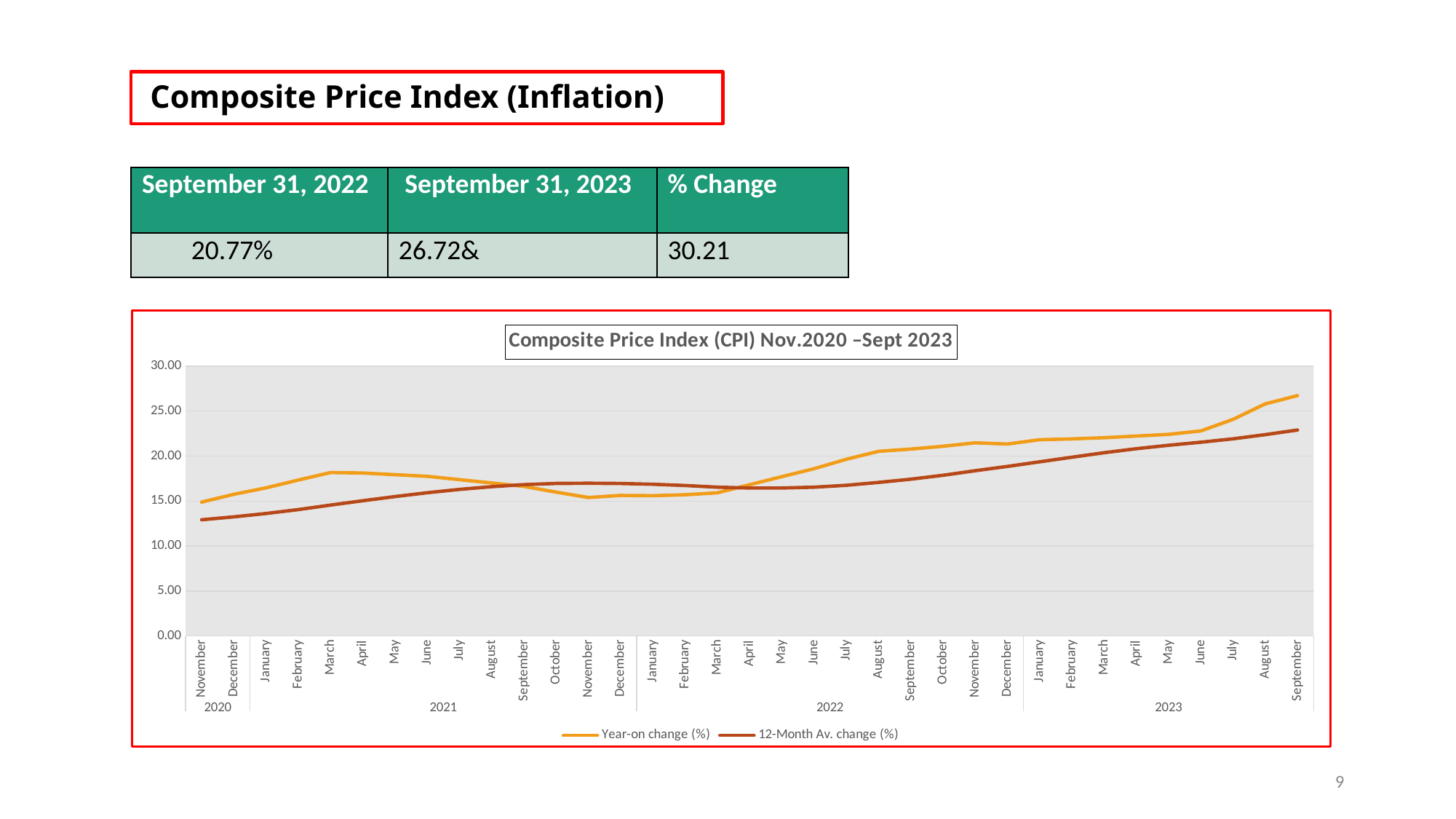
How many series does the chart legend list? 2 What kind of chart is shown on the slide? Line chart At which month does the Year-on change (%) series reach its highest value? September 2023 Is the Year-on change (%) value for September 2023 greater or less than 25? greater Is the Year-on change (%) value for March 2021 greater or less than 15? greater How many monthly data points are plotted along the x axis of the chart? 35 What are the two series named in the chart legend? Year-on change (%) and 12-Month Av. change (%) In November 2021, which series has the higher value, Year-on change (%) or 12-Month Av. change (%)? 12-Month Av. change (%) Is the 12-Month Av. change (%) value for November 2020 greater or less than 15? less What is the title of the chart? Composite Price Index (CPI) Nov.2020 –Sept 2023 In September 2023, which series has the higher value, Year-on change (%) or 12-Month Av. change (%)? Year-on change (%)